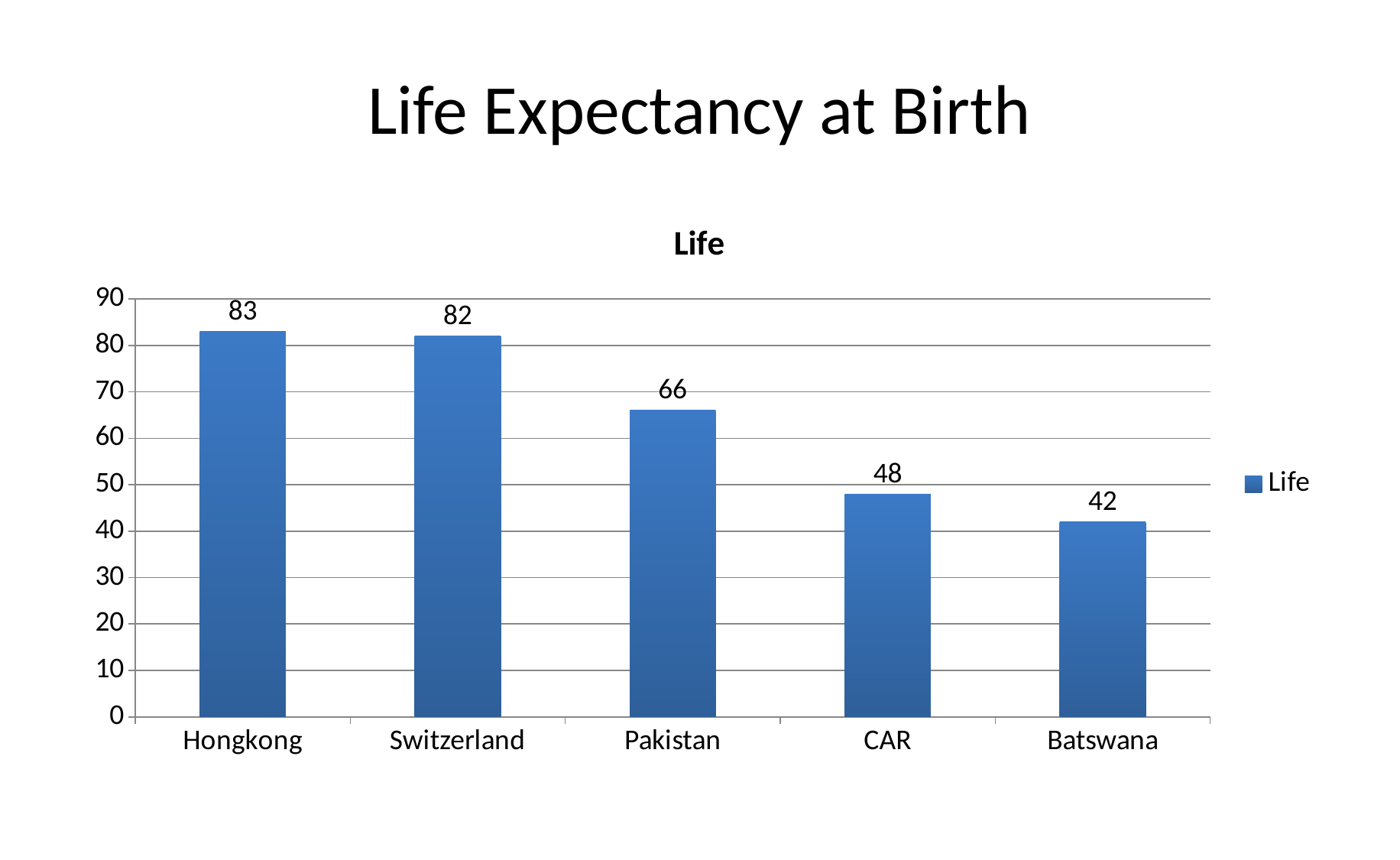
What is the life expectancy value shown for Hongkong? 83 How many series does the legend list? 1 What is the value shown for Pakistan? 66 What is the difference between the values for Pakistan and CAR? 18 Which category has the highest value? Hongkong Which has a larger value, Switzerland or Pakistan? Switzerland What kind of chart is shown on the slide? Bar chart Which category has the lowest value? Batswana What is the value shown for Batswana? 42 Do the values rise or fall from left to right along the x axis? Fall How many categories are shown on the x axis? 5 What is the difference between the values for Hongkong and Batswana? 41